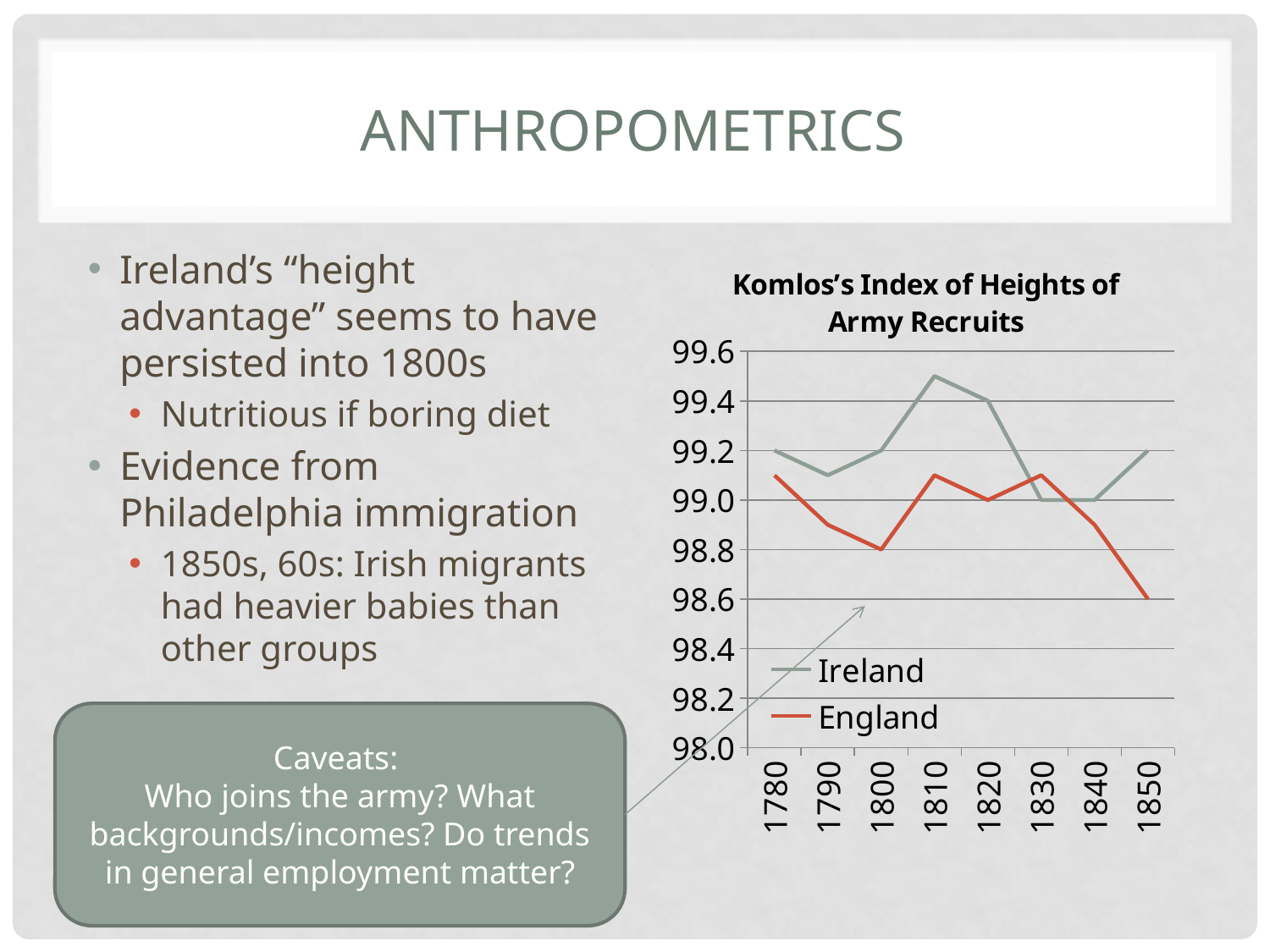
In which year does the Ireland series reach its highest value? 1810 In 1820, which series has the higher value, Ireland or England? Ireland How many series does the legend of the chart list? 2 What is the value for Ireland in 1820? 99.4 Is the value for Ireland in 1810 greater or less than 99.4? greater What kind of chart is shown on the slide? line chart What is the value for England in 1850? 98.6 Does the England series rise or fall between 1830 and 1850? fall What is the title of the chart? Komlos's Index of Heights of Army Recruits In which year does the England series reach its lowest value? 1850 Is the value for England in 1790 greater or less than 99.0? less How many years are plotted along the x axis of the chart? 8